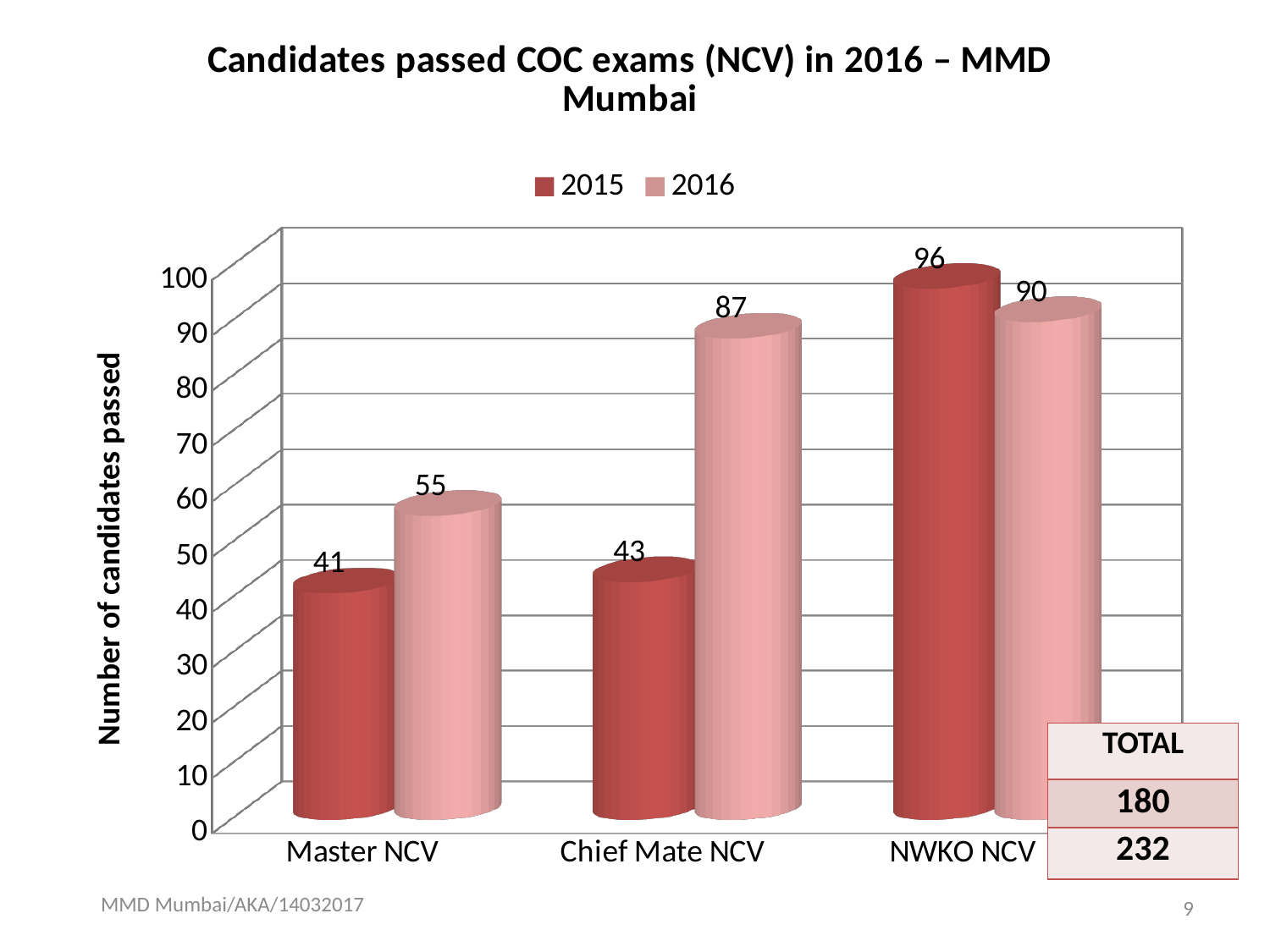
Is the value for Master NCV in 2016 greater or less than 50? greater What is the value for NWKO NCV in 2015? 96 Which category has the lowest value for 2015? Master NCV What kind of chart is shown on the slide? bar chart How many categories are shown on the x axis? 3 How many candidates passed Chief Mate NCV in 2016? 87 How many candidates passed Master NCV in 2015? 41 Which is larger for NWKO NCV, the 2015 value or the 2016 value? 2015 What is the label of the vertical axis? Number of candidates passed Which category has the highest value for 2016? NWKO NCV How many series does the legend list? 2 What is the difference between the 2016 and 2015 values for Chief Mate NCV? 44